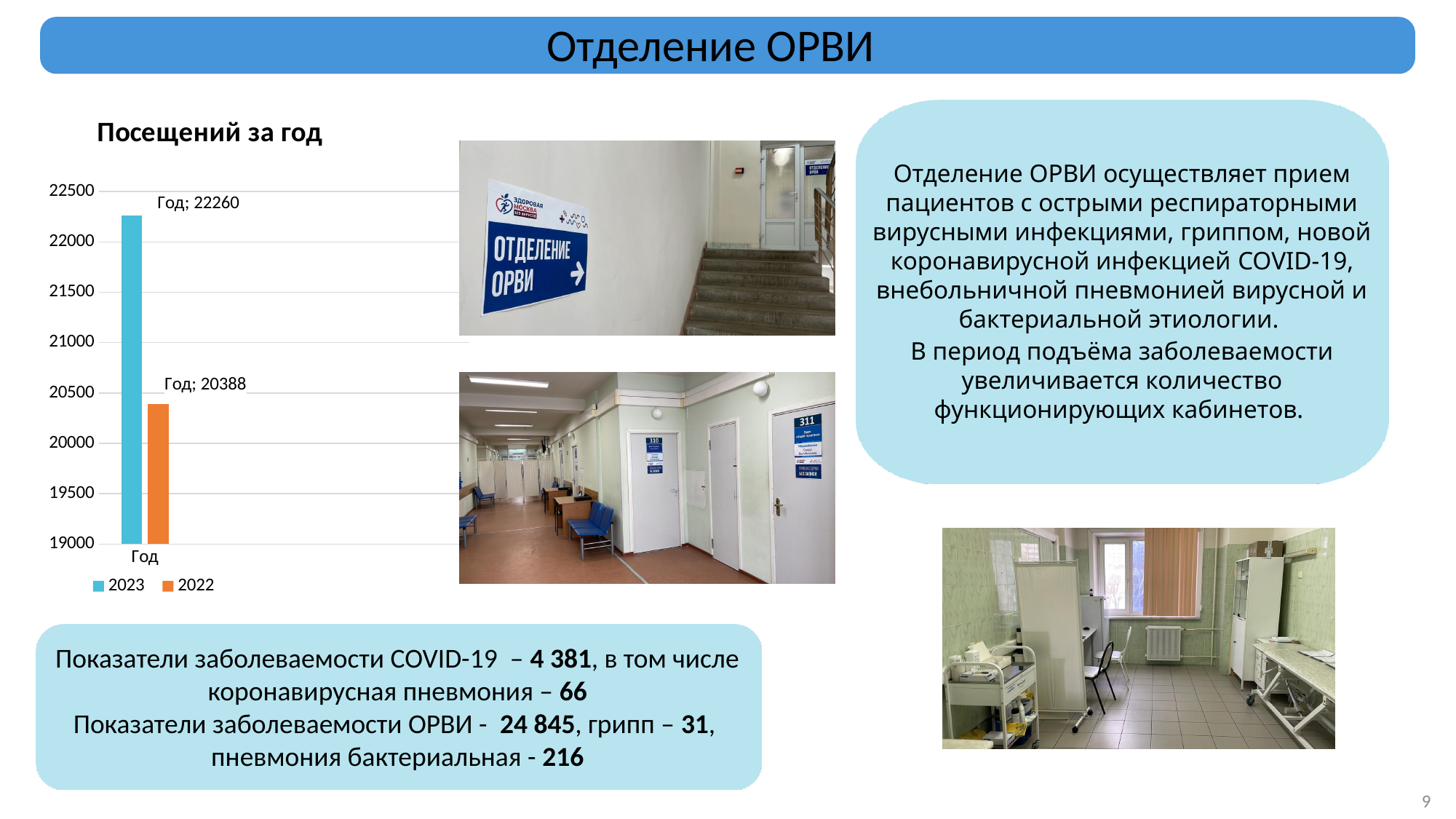
What type of chart is shown on the slide? bar chart What is the value for the 2022 series in the chart? 20388 Which series has the higher value, 2023 or 2022? 2023 Which series has the lowest value in the chart? 2022 What are the series names in the chart legend? 2023, 2022 How many series does the chart legend list? 2 What is the value for the 2023 series in the chart? 22260 What is the difference between the 2023 and 2022 values? 1872 What is the title of the chart? Посещений за год Is the value for 2023 greater or less than 22000? greater How many categories are shown on the x axis of the chart? 1 Is the value for 2022 greater or less than 20500? less